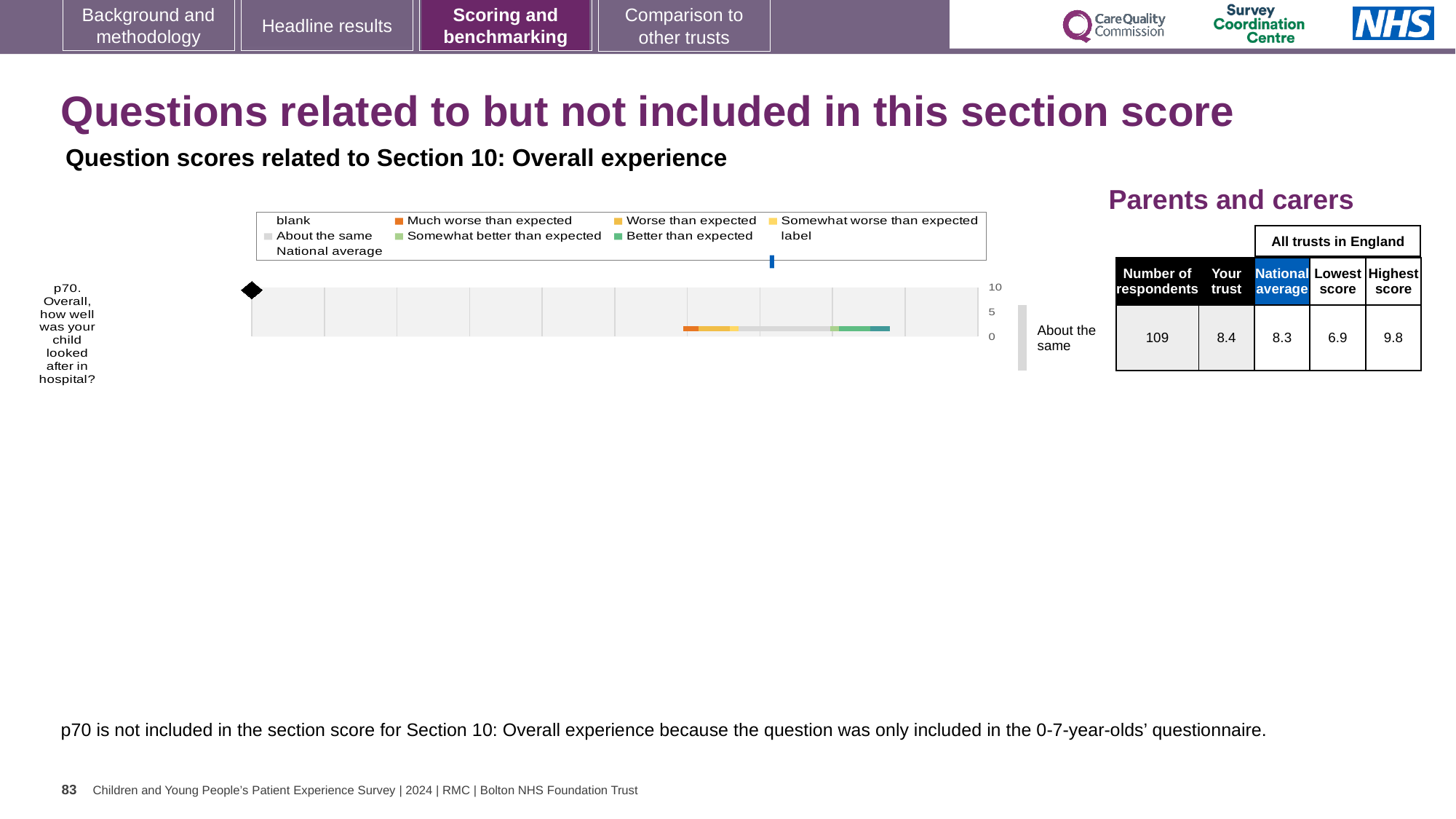
Which is larger for p70, the 'Your trust' score or the national average? Your trust What kind of chart is used to show the p70 question score? bar chart What is the 'Your trust' score for p70? 8.4 What is the difference between the highest score and the lowest score for p70? 2.9 What benchmark label is shown next to the chart for p70? About the same What is the highest value shown on the chart's axis? 10 What is the national average score for p70? 8.3 What is the lowest score among all trusts in England for p70? 6.9 How many respondents answered p70? 109 How many questions are plotted in the chart? 1 What is the highest score among all trusts in England for p70? 9.8 What colour represents 'Much worse than expected' in the legend? orange